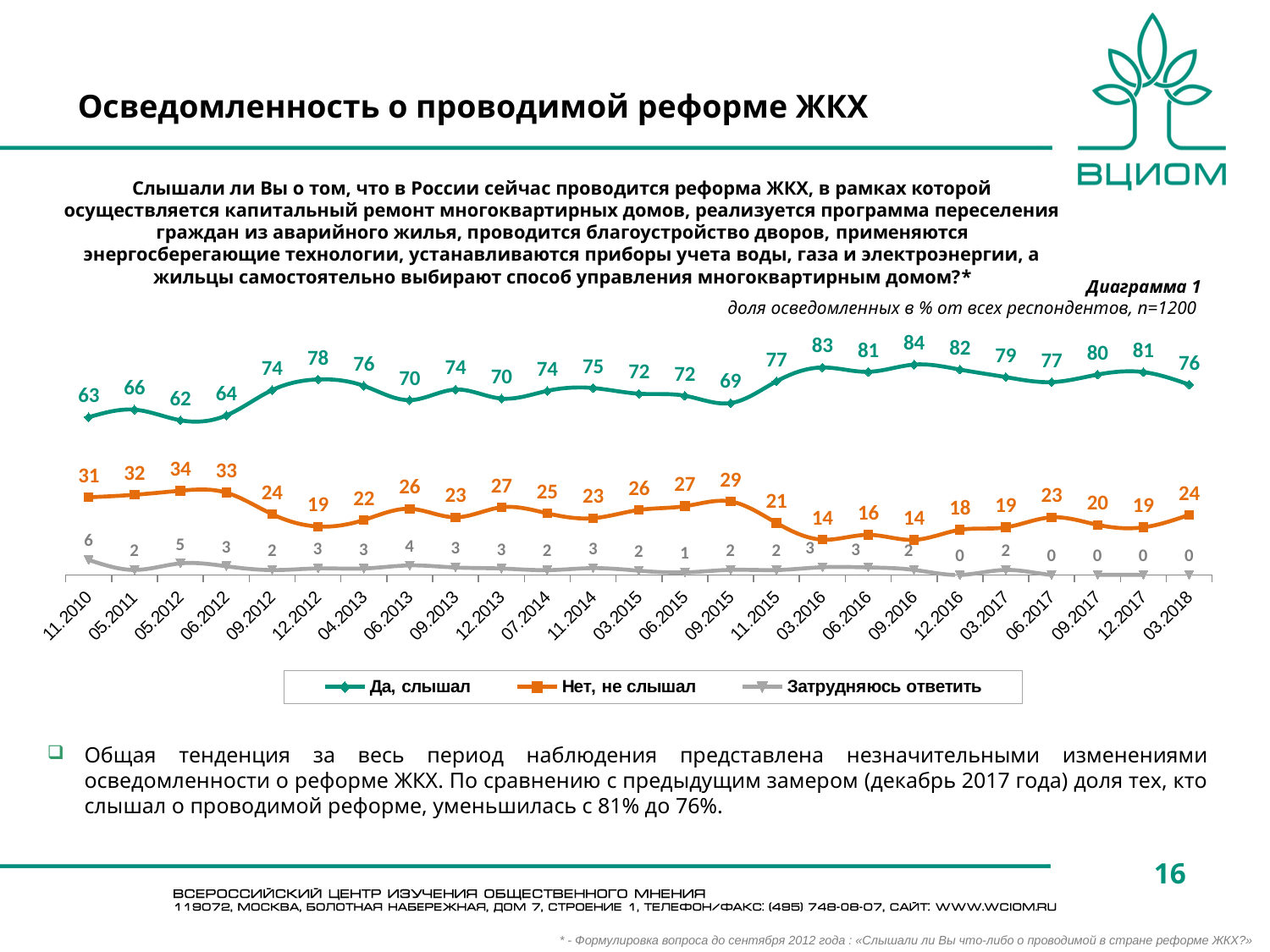
In which period does the 'Нет, не слышал' series reach its highest value? 05.2012 In which period does the 'Да, слышал' series have its lowest value? 05.2012 In which period does the 'Да, слышал' series reach its highest value? 09.2016 What is the difference between the 'Да, слышал' values for 12.2017 and 03.2018? 5 How many time points are plotted on the x axis? 25 Which series is drawn in orange? Нет, не слышал What is the value of the 'Нет, не слышал' series for 11.2010? 31 How many series does the legend list? 3 Which is larger: the 'Нет, не слышал' value for 09.2015 or for 11.2015? 09.2015 What is the value of the 'Затрудняюсь ответить' series for 06.2013? 4 What is the value of the 'Да, слышал' series for 03.2018? 76 What type of chart is shown on the slide? line chart